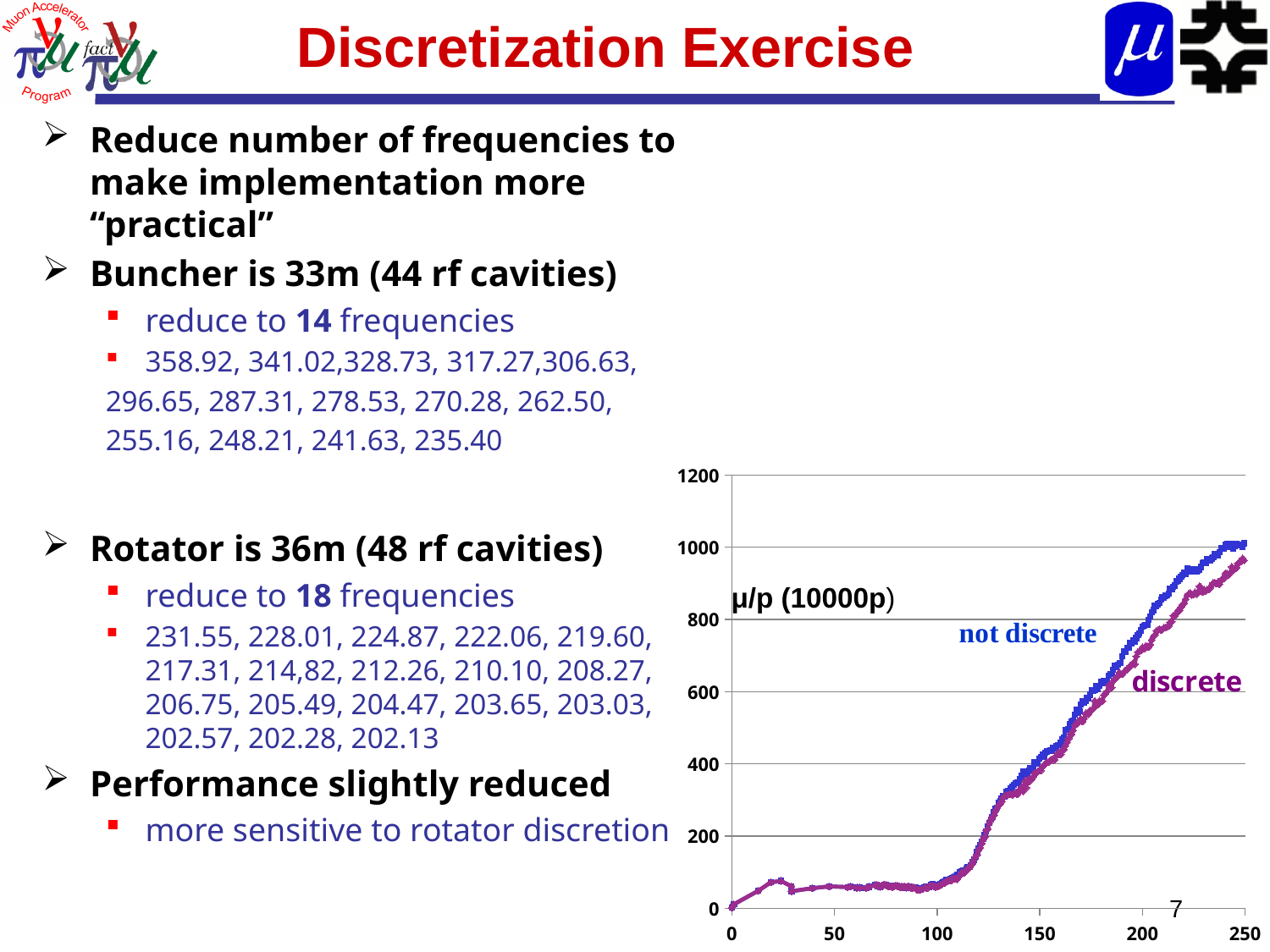
What are the names of the two series plotted on the chart? not discrete, discrete At x = 250, which series has the larger value, 'not discrete' or 'discrete'? not discrete Is the value of the 'not discrete' series at x = 100 greater or less than 200? less What is the highest value shown on the chart's y axis? 1200 Do the plotted values generally rise or fall as the x axis increases from 0 to 250? rise What kind of chart is shown on the slide? line chart How many series are plotted on the chart? 2 Is the value of the 'not discrete' series at x = 50 greater or less than 200? less Is the value of the 'discrete' series at x = 200 greater or less than 600? greater What colour is the 'not discrete' line on the chart? blue At x = 200, which series has the larger value, 'not discrete' or 'discrete'? not discrete